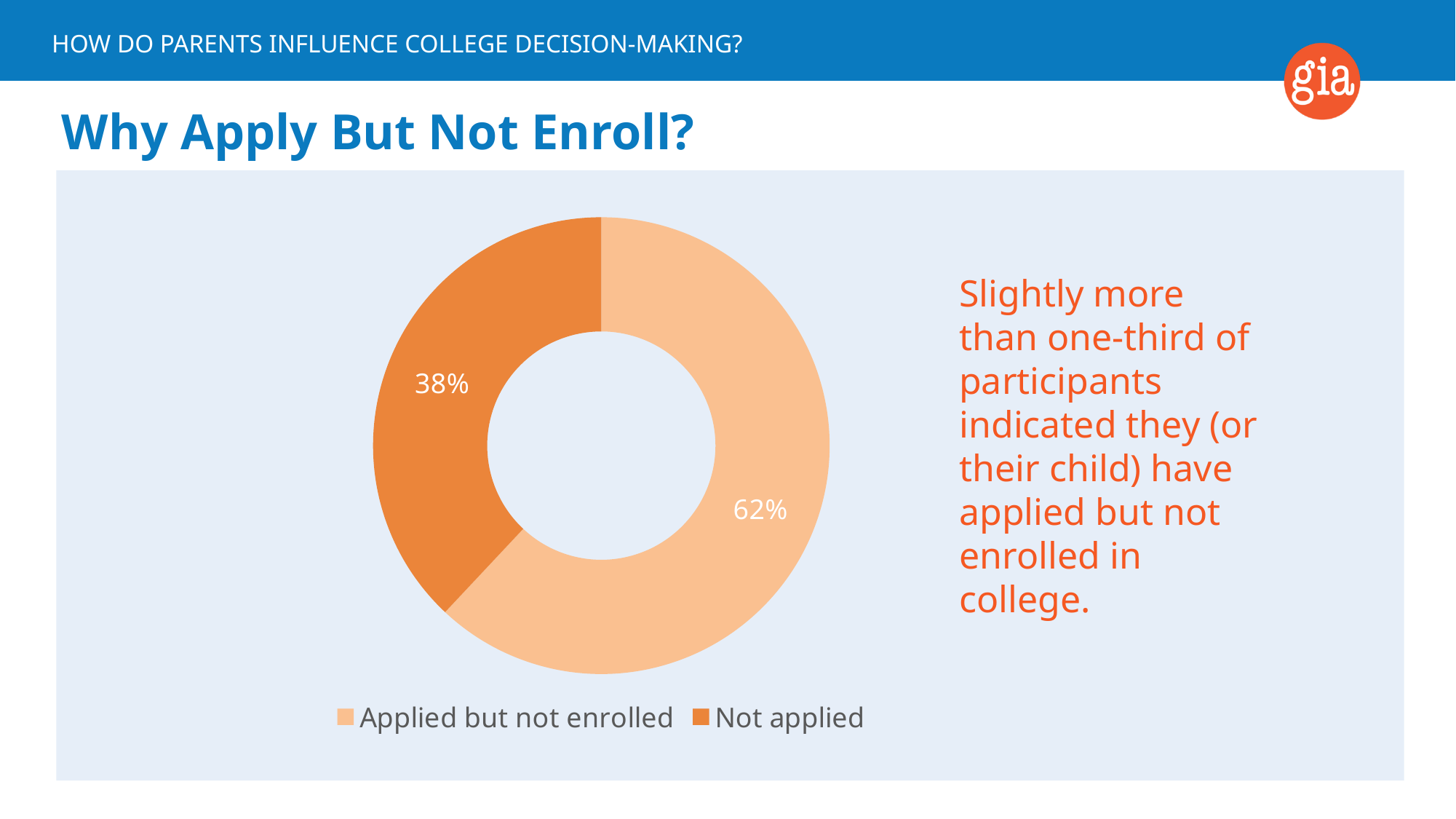
What is the difference in percentage points between 'Applied but not enrolled' and 'Not applied'? 24 Which category has the smaller share of the chart? Not applied How many categories does the chart show? 2 What percentage of participants did not apply? 38% What kind of chart is shown on the slide? Doughnut (pie) chart Which legend entry is shown in the darker orange colour? Not applied Which category has the larger share of the chart? Applied but not enrolled What share of the chart does the 'Not applied' slice represent? 38% How many entries does the legend list? 2 What percentage of participants applied but did not enroll? 62% Which is larger: the share for 'Not applied' or the share for 'Applied but not enrolled'? Applied but not enrolled What is the title of the slide containing the chart? Why Apply But Not Enroll?